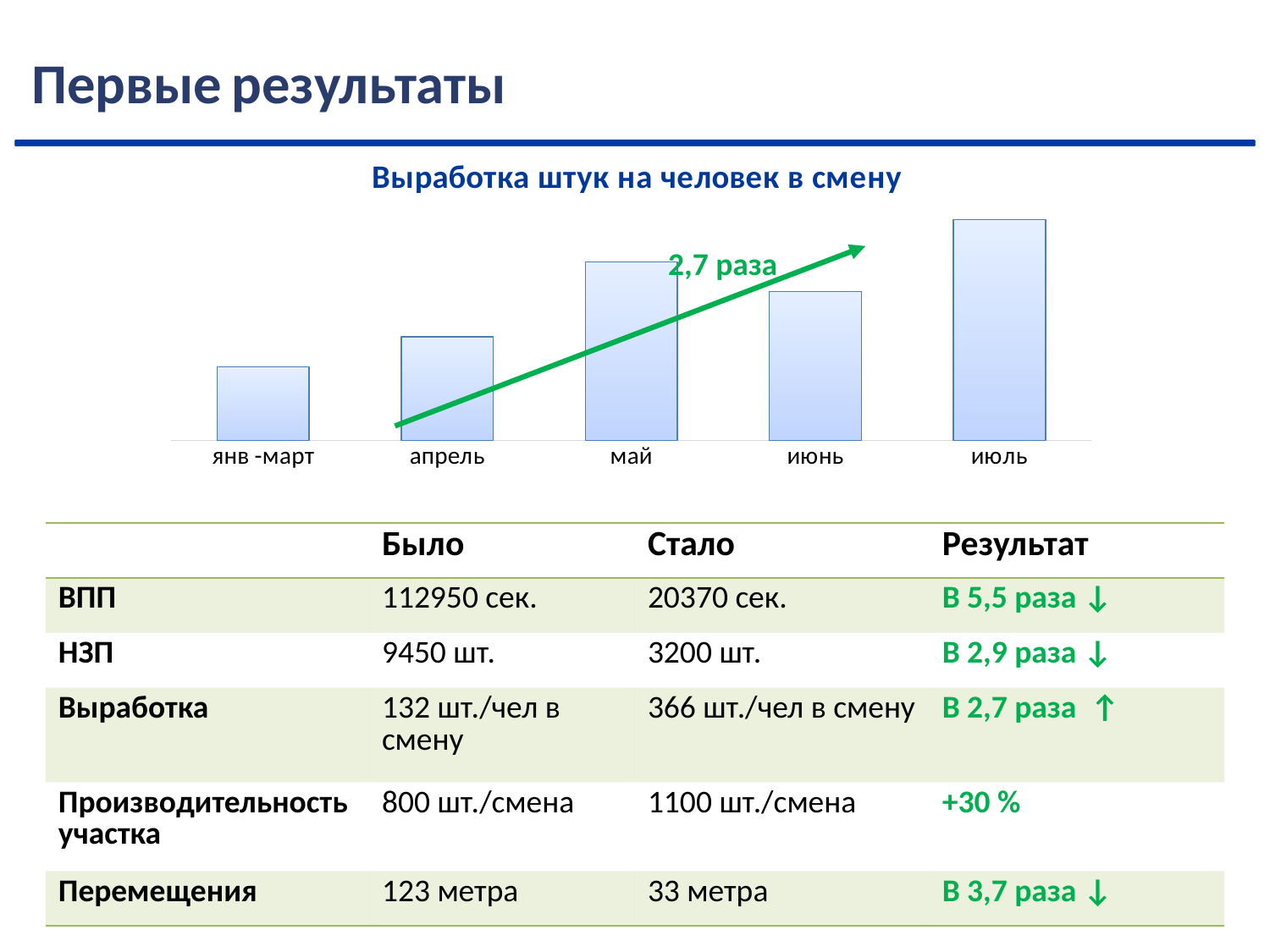
How many categories are shown on the x axis of the chart? 5 Which bar is taller, июнь or июль? июль Which bar is taller, май or июнь? май Which bar is taller, апрель or май? май Do the bars rise or fall from янв -март to май? rise What is the title of the chart? Выработка штук на человек в смену What kind of chart is shown on the slide? bar chart Which category has the lowest bar in the chart? янв -март Which category has the highest bar in the chart? июль What text is written next to the green arrow on the chart? 2,7 раза